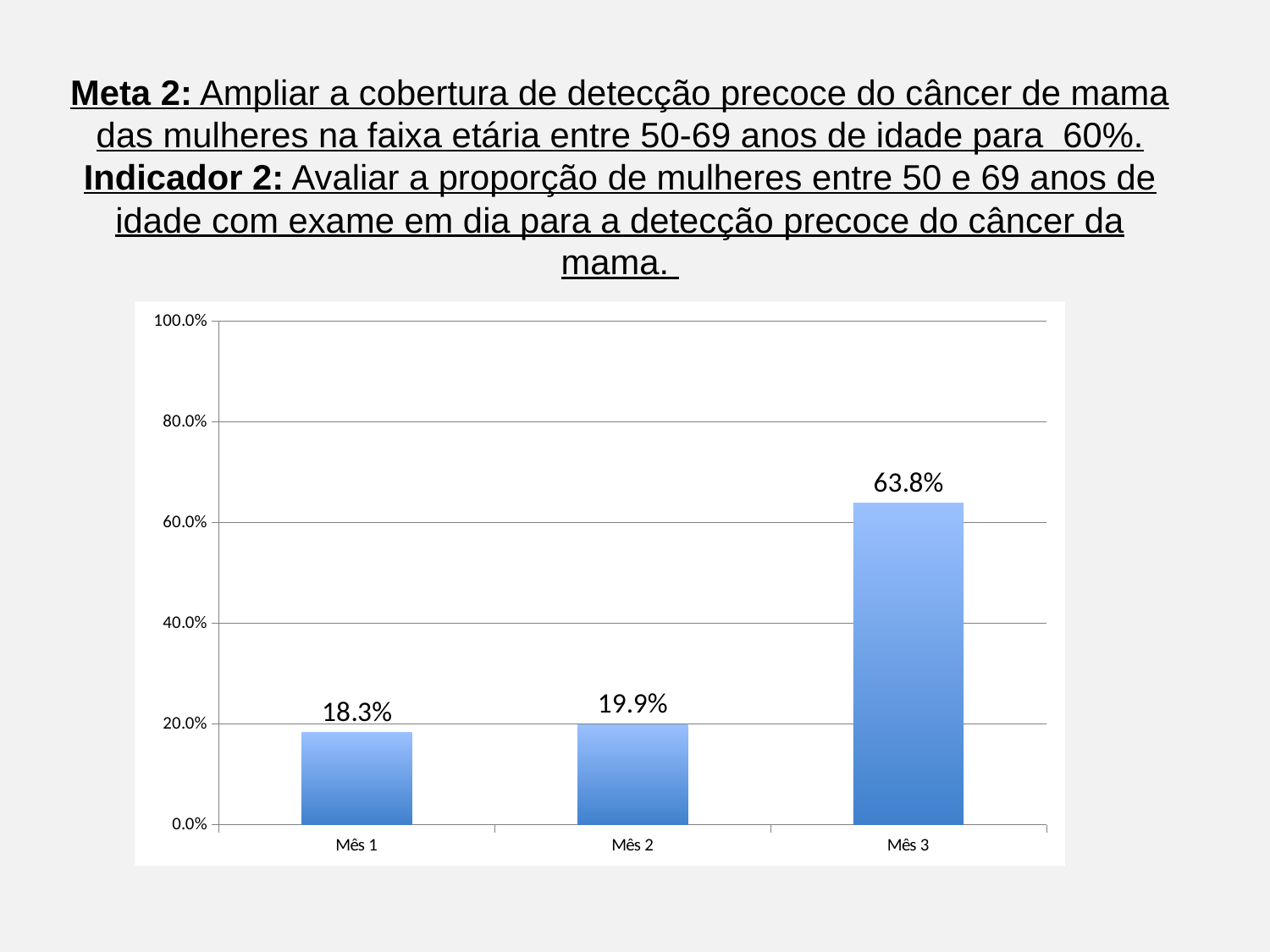
Which month has the highest value? Mês 3 Which month has the lowest value? Mês 1 What is the value for Mês 1? 18.3% How many categories are shown on the x axis? 3 What is the value for Mês 2? 19.9% Do the values rise or fall from Mês 1 to Mês 3? rise Which is larger, the value for Mês 3 or the value for Mês 1? Mês 3 Is the value for Mês 3 greater or less than 60.0%? greater What is the value for Mês 3? 63.8% What is the difference between the values for Mês 3 and Mês 2? 43.9% What kind of chart is shown on the slide? bar chart What is the difference between the values for Mês 2 and Mês 1? 1.6%